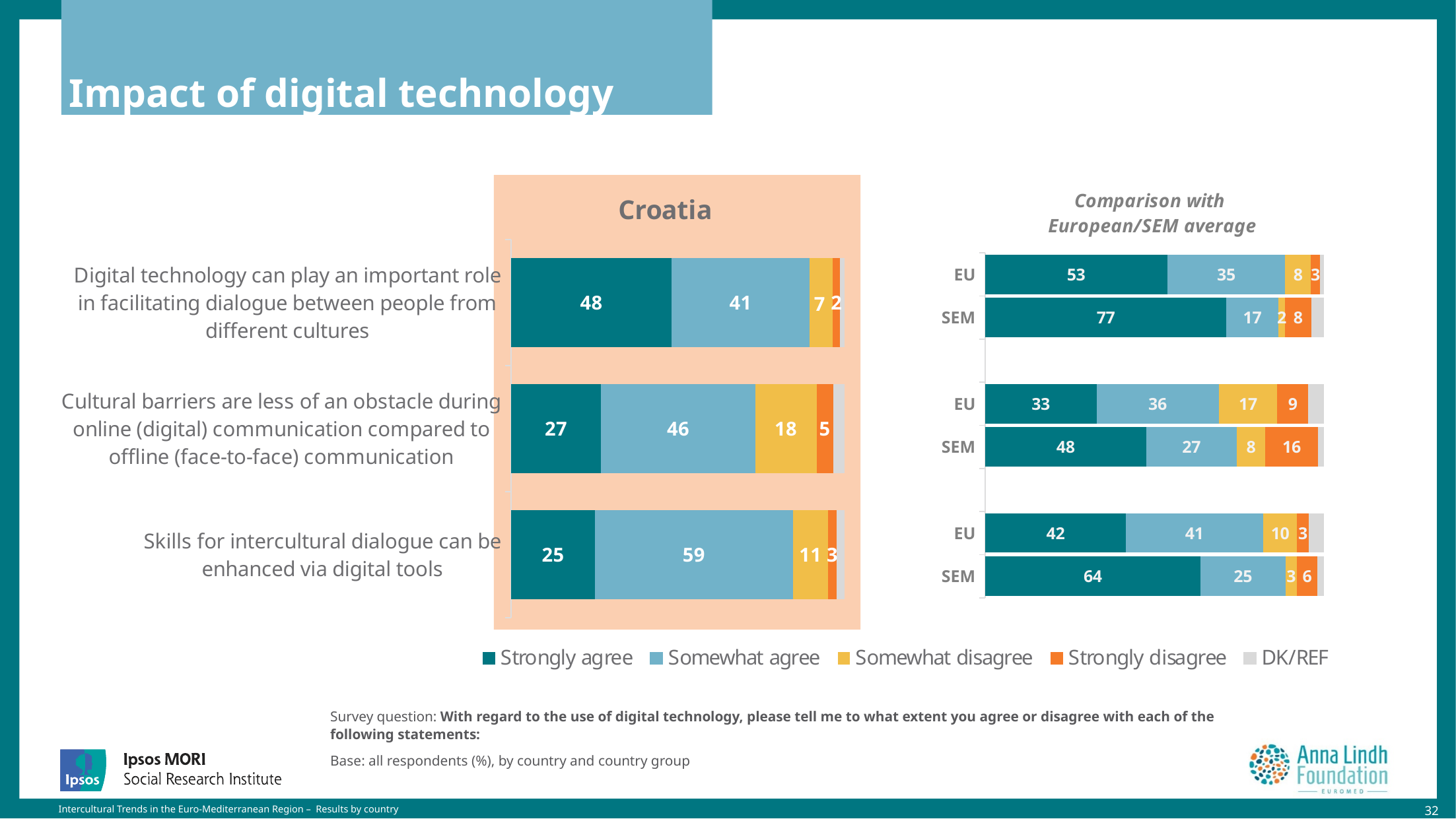
In the 'Comparison with European/SEM average' chart, what is the SEM 'Strongly agree' value for the statement about digital technology facilitating dialogue? 77 In the Croatia chart, what percentage strongly agree that digital technology can play an important role in facilitating dialogue between people from different cultures? 48 In the Croatia chart, which statement has the highest 'Strongly agree' value? Digital technology can play an important role in facilitating dialogue between people from different cultures How many series does the legend list? 5 In the 'Comparison with European/SEM average' chart, what is the difference between the SEM and EU 'Strongly agree' values for the statement about digital technology facilitating dialogue? 24 In the 'Comparison with European/SEM average' chart, what is the EU 'Somewhat disagree' value for the statement that cultural barriers are less of an obstacle during online communication? 17 In the Croatia chart, what is the difference between the 'Somewhat disagree' values for 'Cultural barriers are less of an obstacle during online (digital) communication' and 'Skills for intercultural dialogue can be enhanced via digital tools'? 7 What kind of chart is the Croatia chart? Stacked bar chart In the Croatia chart, which has the larger 'Strongly agree' value: the digital technology dialogue statement or the cultural barriers statement? Digital technology can play an important role in facilitating dialogue between people from different cultures What is the title of the chart on the right side of the slide? Comparison with European/SEM average In the Croatia chart, what is the 'Somewhat agree' value for 'Skills for intercultural dialogue can be enhanced via digital tools'? 59 How many statements are shown in the Croatia chart? 3